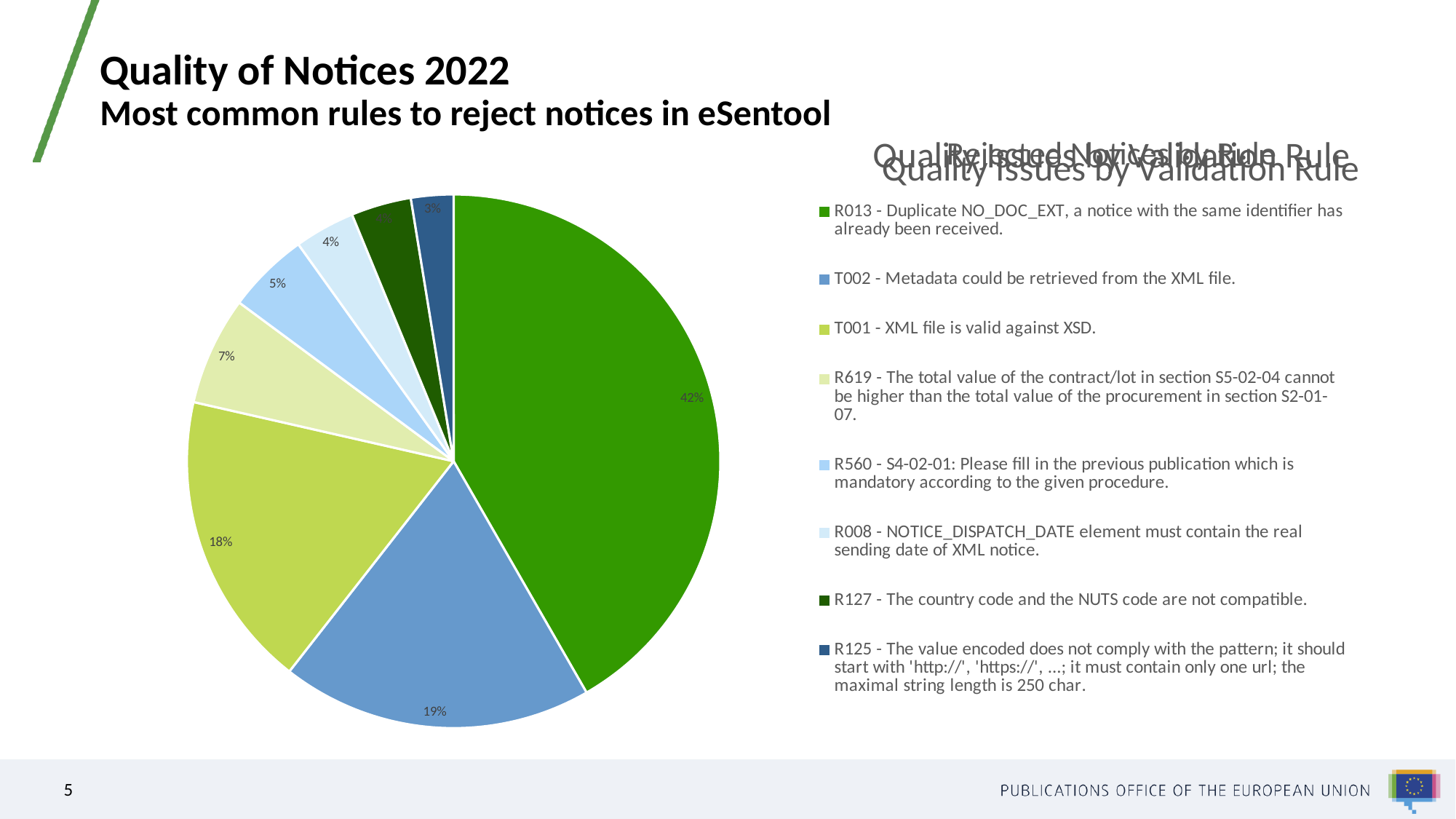
How many percentage points larger is the R013 slice than the T002 slice? 23 percentage points How many validation rules are listed in the legend? 8 What percentage is shown for T002 (Metadata could be retrieved from the XML file)? 19% What percentage is shown for R125 (value encoded does not comply with the pattern)? 3% What percentage is shown for R619 (total value of the contract/lot cannot be higher than the total value of the procurement)? 7% What kind of chart is shown on the slide? pie chart What percentage is shown for R560 (S4-02-01: Please fill in the previous publication)? 5% What percentage is shown for T001 (XML file is valid against XSD)? 18% Which validation rule has the largest slice of the pie? R013 - Duplicate NO_DOC_EXT What percentage is shown for R008 (NOTICE_DISPATCH_DATE element must contain the real sending date)? 4% Which slice is larger, T002 or T001? T002 What share of the pie does R013 (Duplicate NO_DOC_EXT) account for? 42%